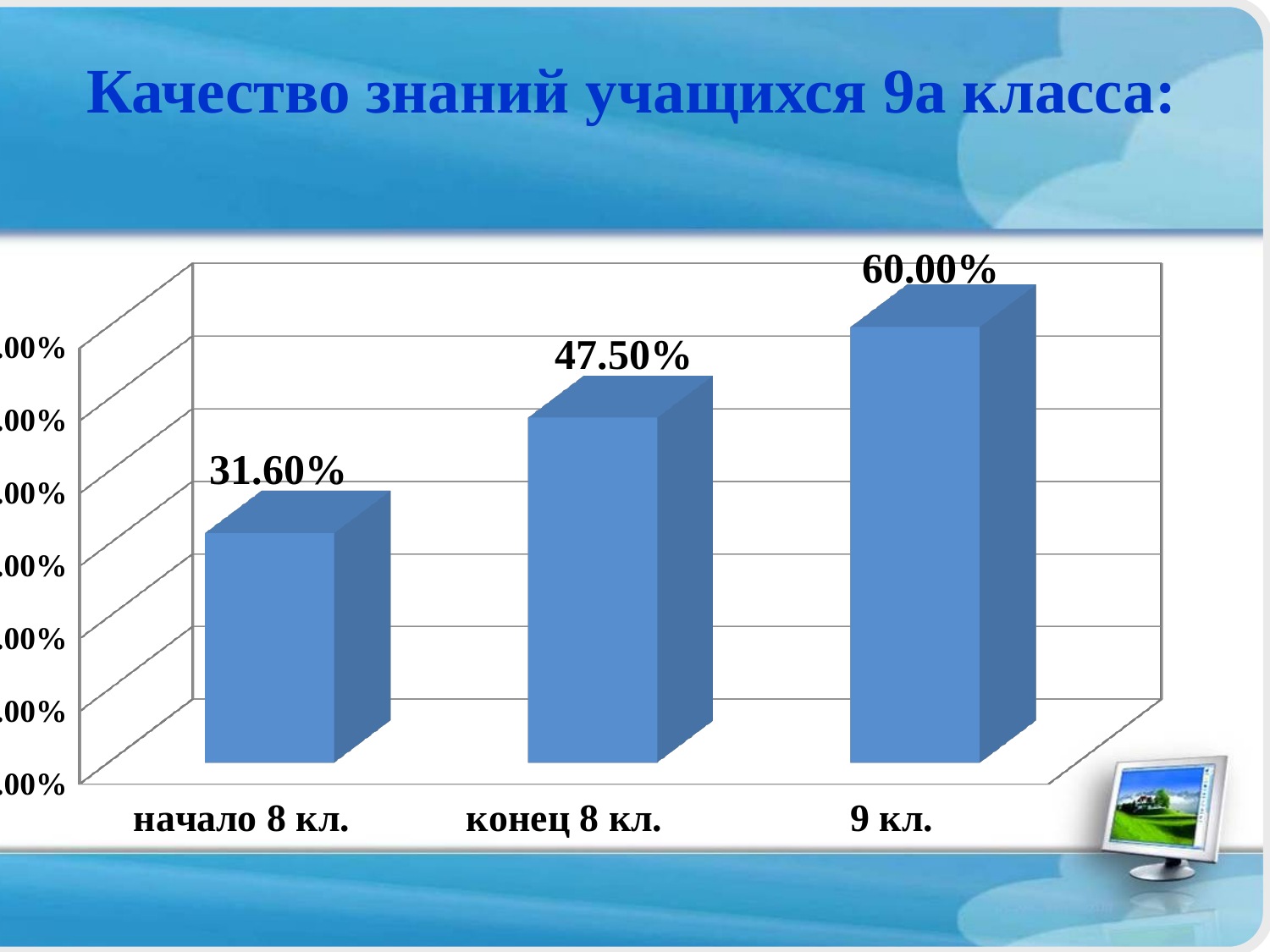
What is the value for "конец 8 кл."? 47.50% What is the difference between the values for "конец 8 кл." and "начало 8 кл."? 15.90% Do the values rise or fall from left to right along the x axis? rise What is the value for "начало 8 кл."? 31.60% Which category has the highest value? 9 кл. Which category has the lowest value? начало 8 кл. What kind of chart is shown on the slide? bar chart Which is larger, the value for "конец 8 кл." or the value for "начало 8 кл."? конец 8 кл. What is the difference between the values for "9 кл." and "начало 8 кл."? 28.40% How many categories are shown on the chart? 3 What is the difference between the values for "9 кл." and "конец 8 кл."? 12.50% What is the value for "9 кл."? 60.00%